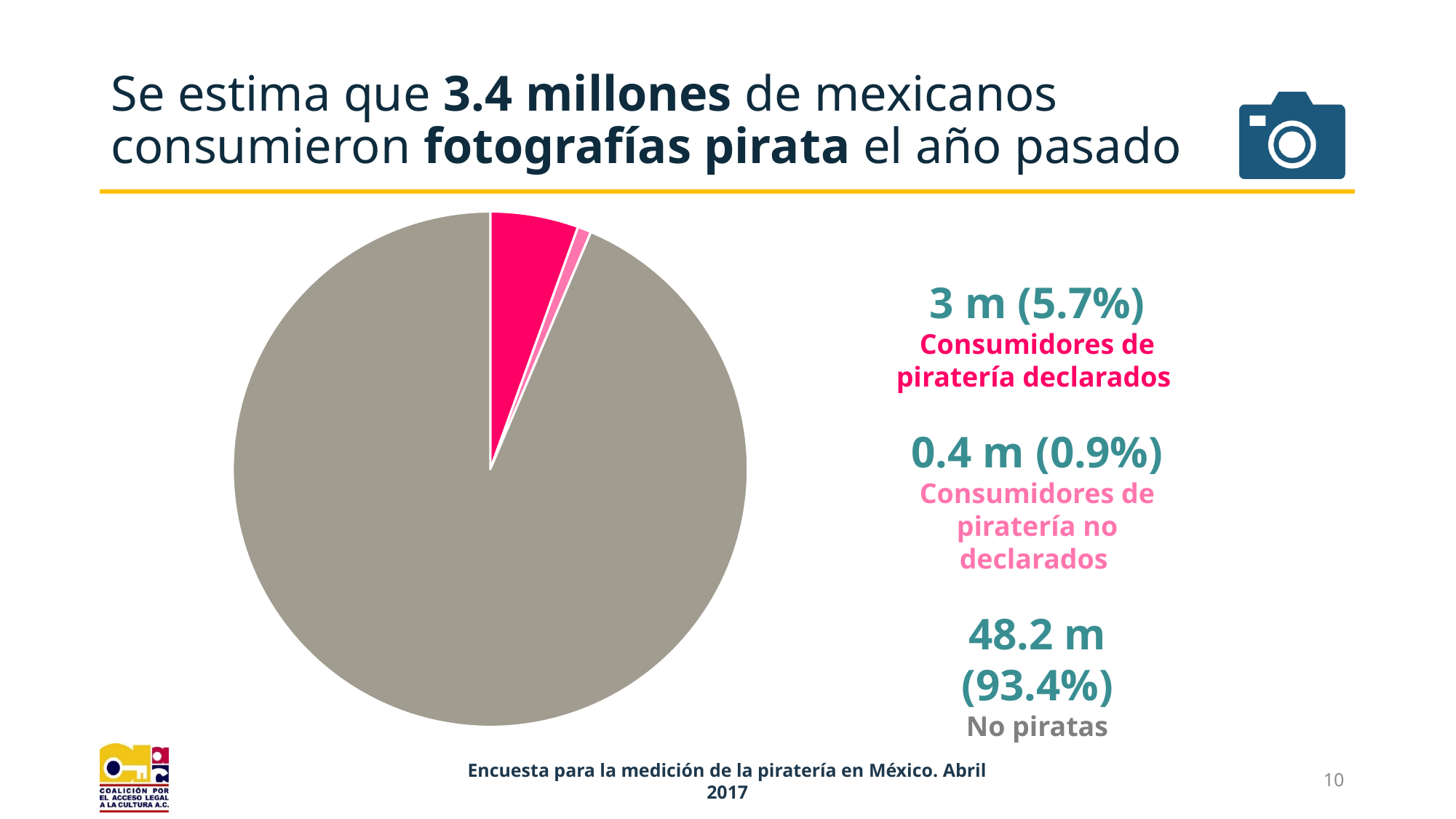
What share of the pie is labelled 'Consumidores de piratería declarados'? 5.7% How many people (in millions) are 'Consumidores de piratería no declarados'? 0.4 m Which category has the smallest slice of the pie? Consumidores de piratería no declarados Which is larger: the share for 'Consumidores de piratería declarados' or for 'Consumidores de piratería no declarados'? Consumidores de piratería declarados What share of the pie is labelled 'No piratas'? 93.4% What is the difference in percentage points between the 'No piratas' share and the 'Consumidores de piratería declarados' share? 87.7 How many slices does the pie chart have? 3 Which category has the largest slice of the pie? No piratas What share of the pie is labelled 'Consumidores de piratería no declarados'? 0.9% How many people (in millions) are 'Consumidores de piratería declarados'? 3 m How many people (in millions) are 'No piratas'? 48.2 m What kind of chart is shown on the slide? Pie chart